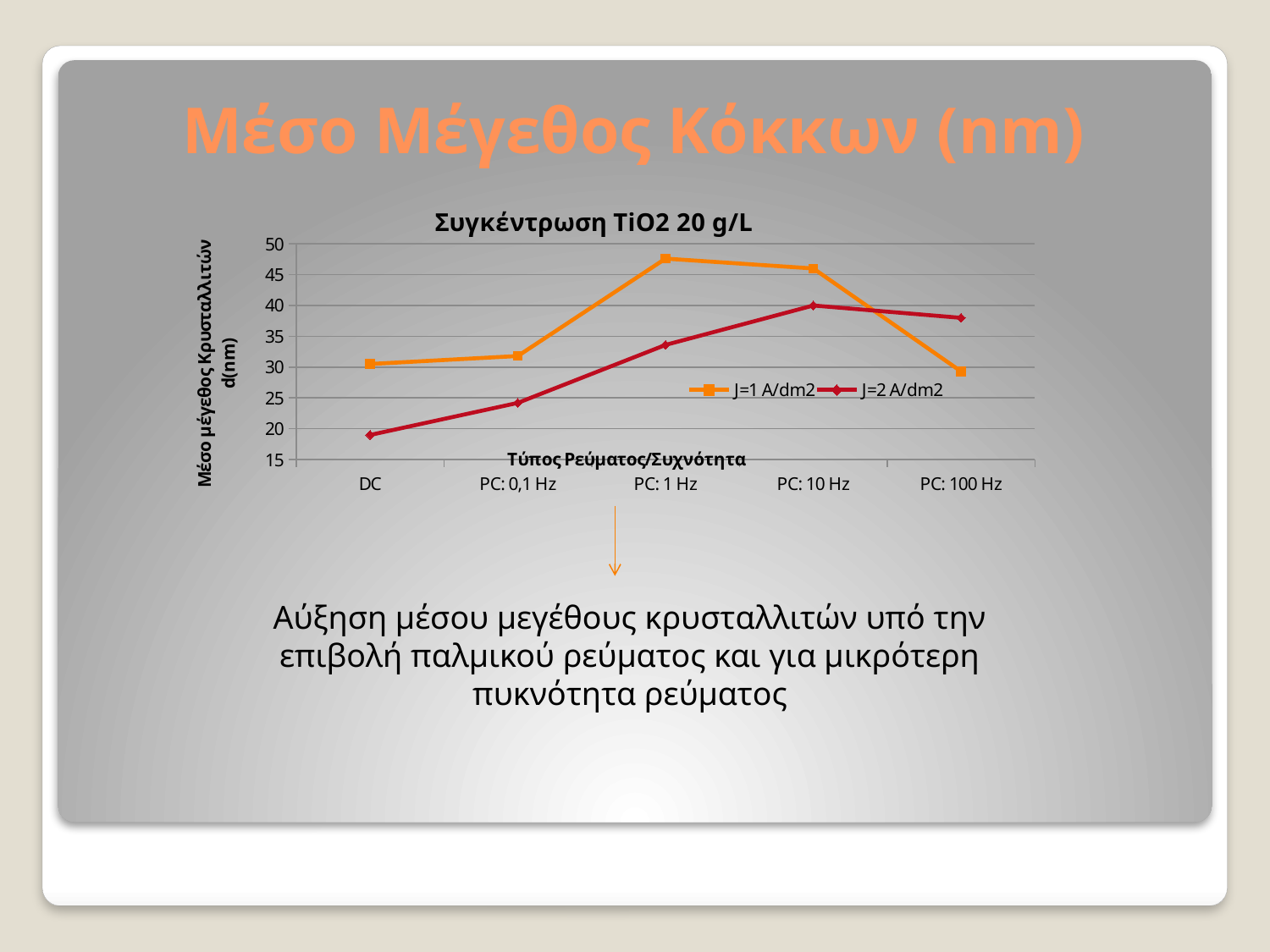
At PC: 100 Hz, which series has the larger value, J=1 A/dm2 or J=2 A/dm2? J=2 A/dm2 Is the value for J=1 A/dm2 at PC: 1 Hz greater or less than 45? greater Is the value for J=2 A/dm2 at DC greater or less than 20? less What is the title of the chart? Συγκέντρωση TiO2 20 g/L How many series does the legend list? 2 For the J=1 A/dm2 series, at which category is the value highest? PC: 1 Hz For the J=2 A/dm2 series, at which category is the value highest? PC: 10 Hz At PC: 1 Hz, which series has the larger value, J=1 A/dm2 or J=2 A/dm2? J=1 A/dm2 What kind of chart is shown on the slide? line chart Which series is drawn in orange? J=1 A/dm2 How many categories are shown on the x axis? 5 For the J=2 A/dm2 series, at which category is the value lowest? DC